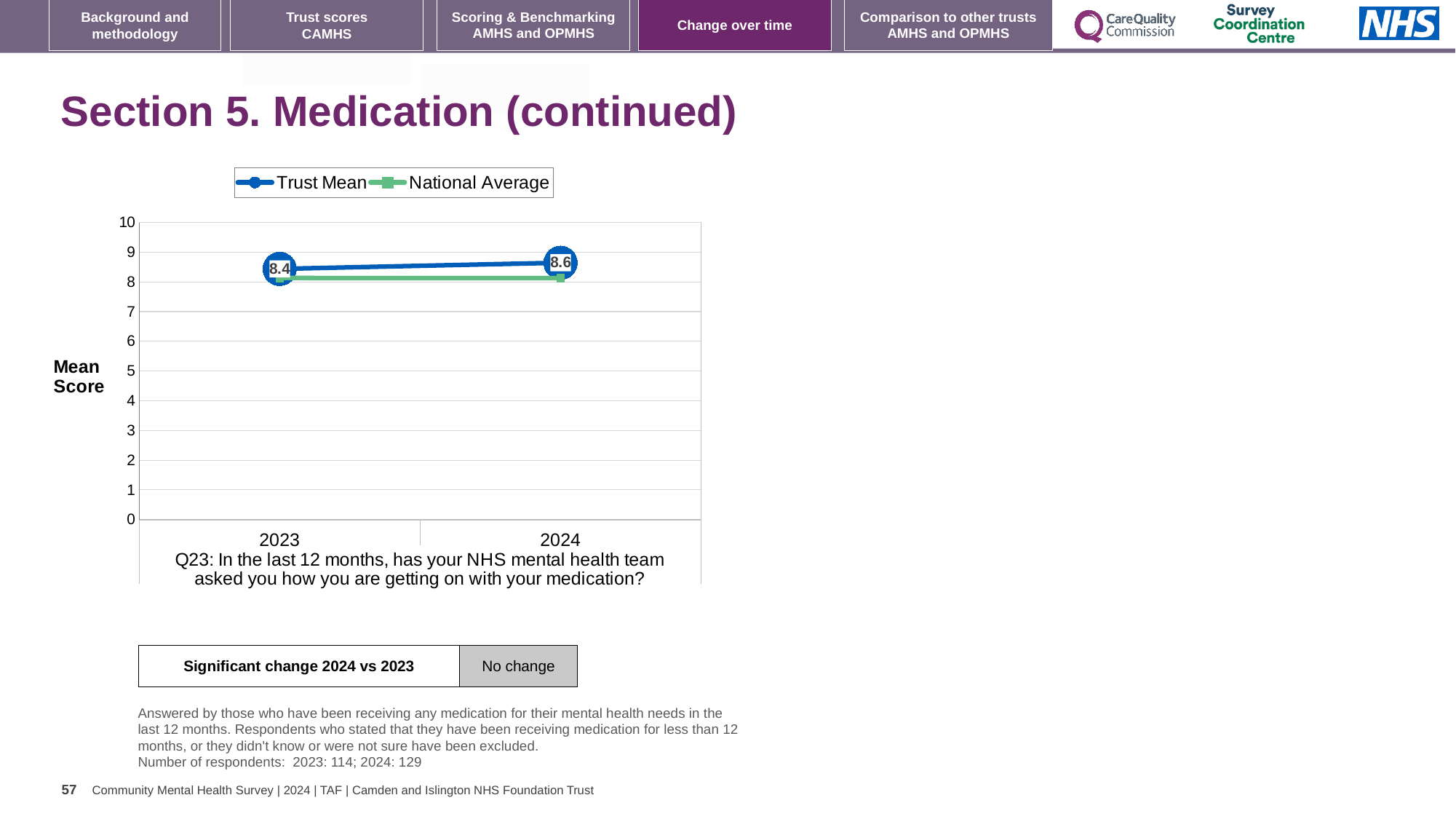
By how much did the Trust Mean change from 2023 to 2024? 0.2 Which year has the higher Trust Mean score? 2024 What is the label on the y axis of the chart? Mean Score What kind of chart is shown on the slide? line chart What is the Trust Mean score for 2024? 8.6 How many series does the legend list? 2 Is the Trust Mean for 2024 larger or smaller than the Trust Mean for 2023? larger How many years are plotted on the x axis? 2 Is the National Average value for 2024 greater or less than 9? less What is the Trust Mean score for 2023? 8.4 Does the Trust Mean rise or fall from 2023 to 2024? rise Is the National Average value for 2023 greater or less than 7? greater